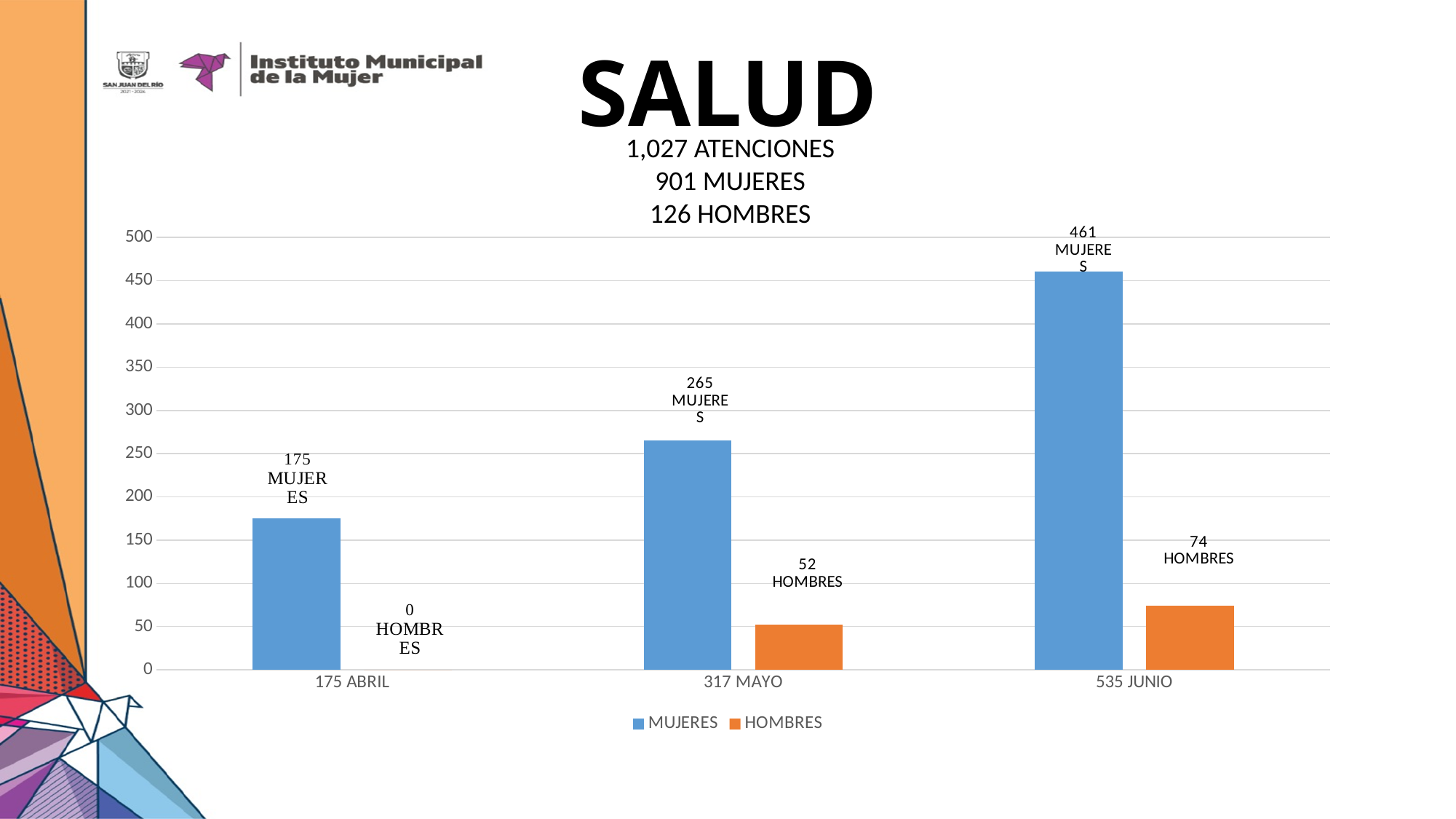
Which category has the highest MUJERES value? 535 JUNIO Do the MUJERES values rise or fall from 175 ABRIL to 535 JUNIO? Rise What is the difference between the MUJERES values for 535 JUNIO and 317 MAYO? 196 What kind of chart is shown on the slide? Bar chart What is the MUJERES value for 535 JUNIO? 461 How many categories are shown on the x axis? 3 What is the HOMBRES value for 317 MAYO? 52 How many series does the legend list? 2 What is the MUJERES value for 175 ABRIL? 175 What is the HOMBRES value for 175 ABRIL? 0 Which is larger: the HOMBRES value for 535 JUNIO or for 317 MAYO? 535 JUNIO Which category has the lowest HOMBRES value? 175 ABRIL